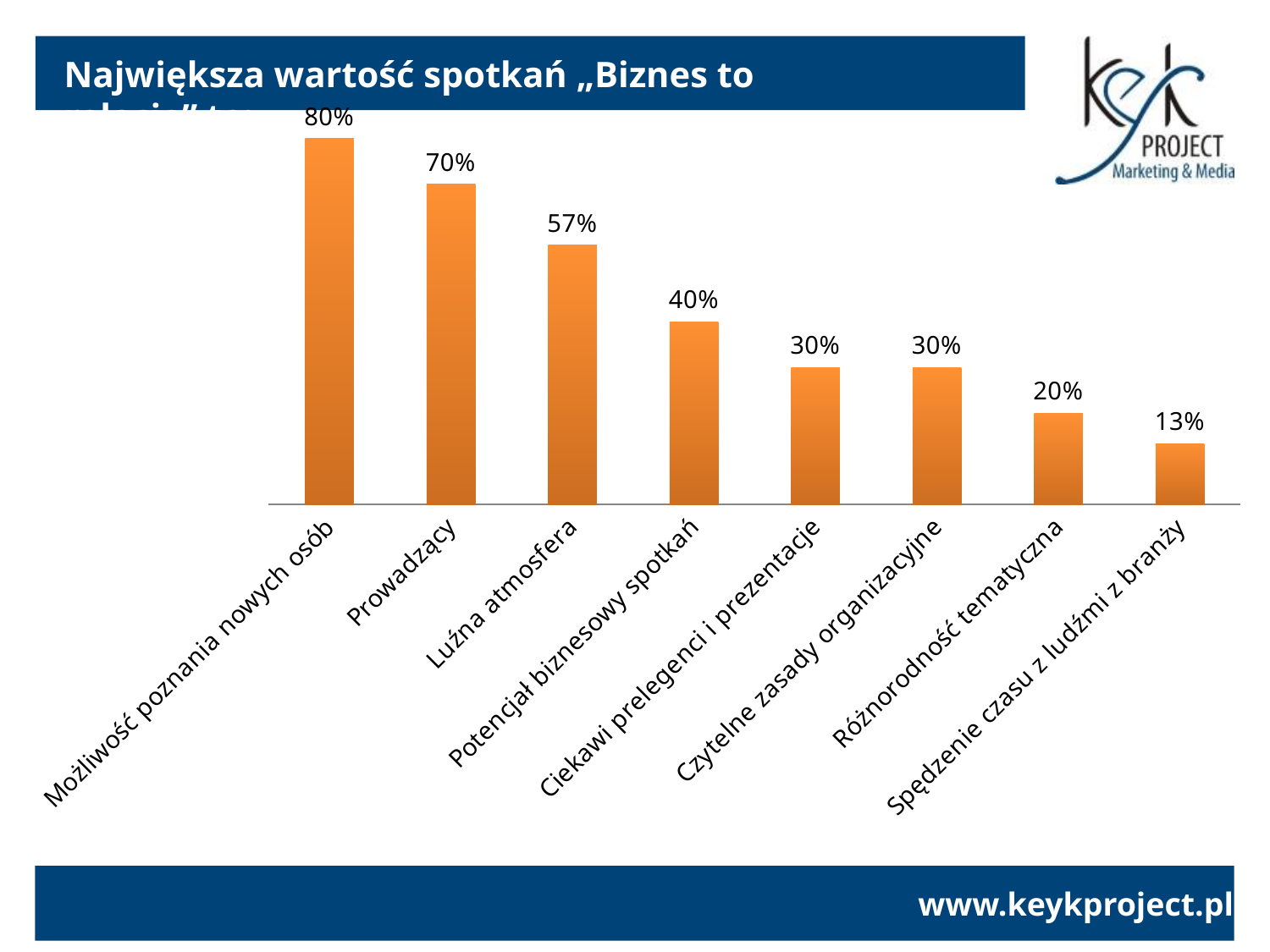
Which category has the highest value? Możliwość poznania nowych osób Which is larger, the value for Luźna atmosfera or the value for Czytelne zasady organizacyjne? Luźna atmosfera What is the value for Luźna atmosfera? 57% What is the value for Ciekawi prelegenci i prezentacje? 30% How many categories are shown in the chart? 8 Which category has the lowest value? Spędzenie czasu z ludźmi z branży What kind of chart is shown on the slide? Bar chart What is the value for Możliwość poznania nowych osób? 80% Do the values rise or fall from left to right along the x axis? Fall What is the difference between the values for Prowadzący and Potencjał biznesowy spotkań? 30% What is the value for Różnorodność tematyczna? 20% What colour are the bars in the chart? Orange